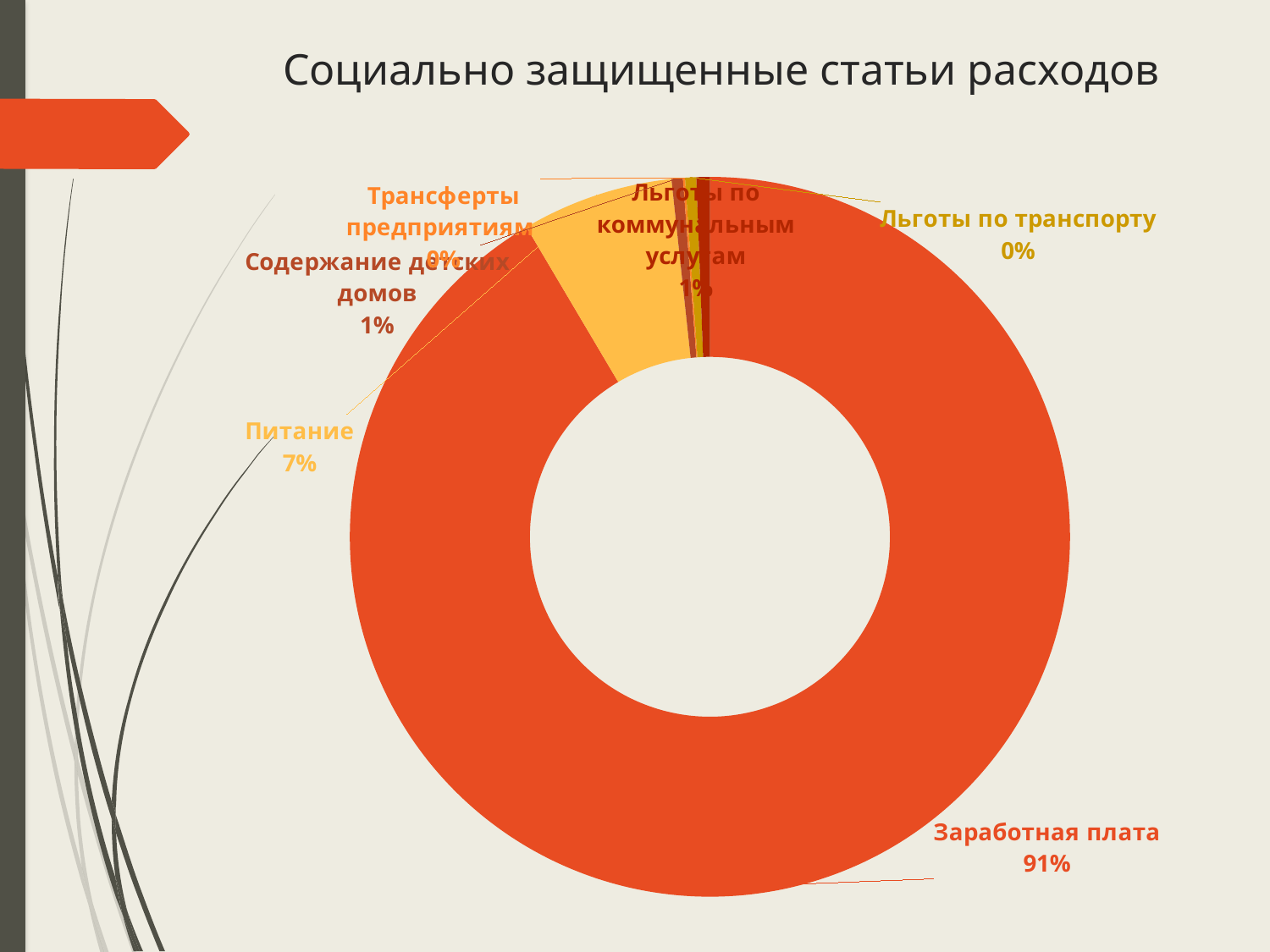
What is the difference in percentage points between Заработная плата and Питание? 84 What percentage is shown for Льготы по транспорту? 0% What share of the chart does Питание take? 7% Which category has the largest share of the chart? Заработная плата What percentage is shown for Льготы по коммунальным услугам? 1% What percentage is shown for Содержание детских домов? 1% What kind of chart is shown on the slide? Doughnut (pie) chart Which is larger, the share for Питание or the share for Содержание детских домов? Питание What share of the chart does Заработная плата take? 91% What is the title of the chart? Социально защищенные статьи расходов How many categories are shown in the chart? 6 What percentage is shown for Трансферты предприятиям? 0%